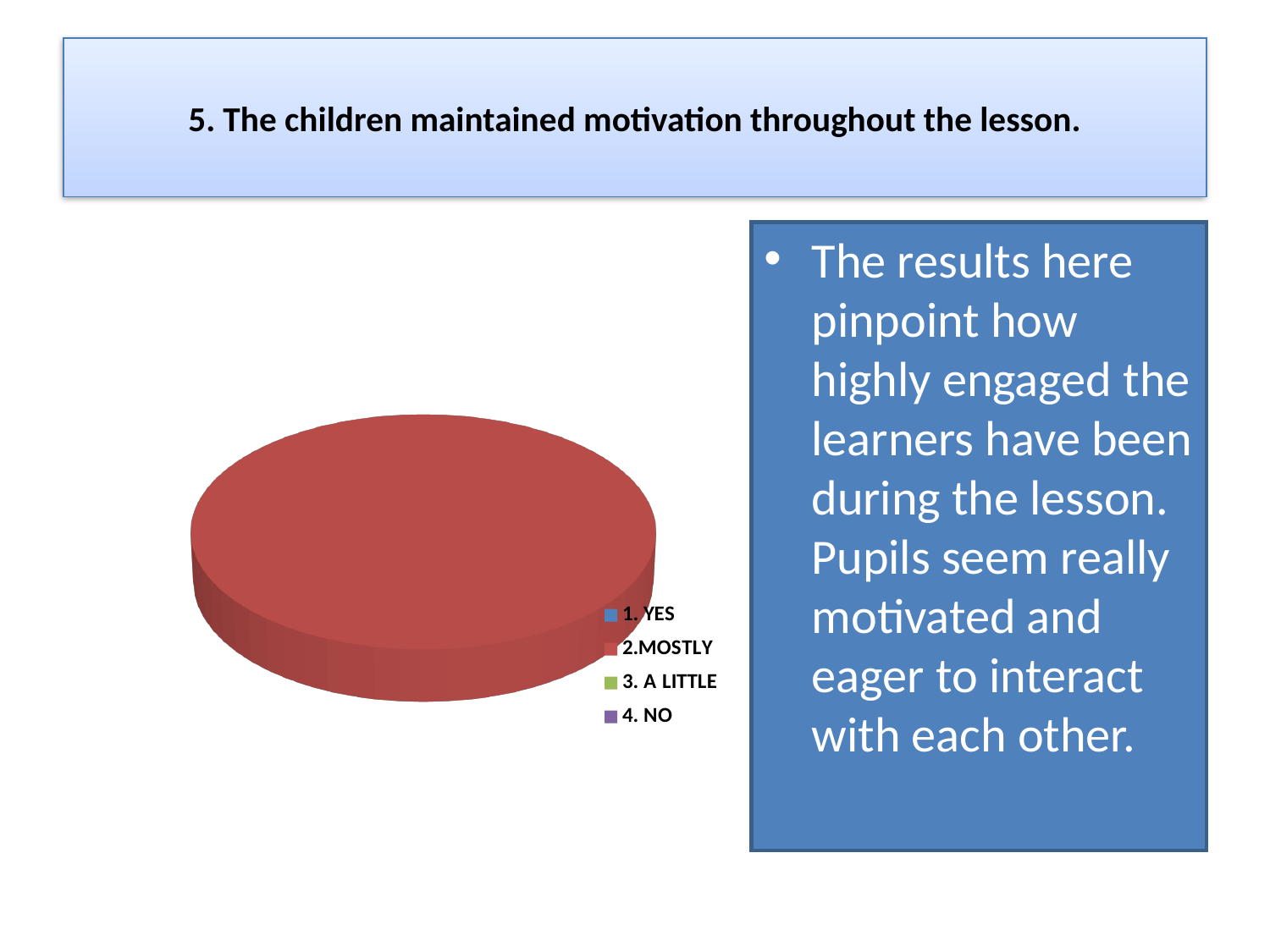
Is the share for 2.MOSTLY in the pie chart greater or less than 50%? greater What is the first category listed in the pie chart's legend? 1. YES How many categories does the legend of the pie chart list? 4 What kind of chart is shown on the slide? pie chart How many visibly distinct slices does the pie chart show? 1 Which category accounts for the largest share of the pie chart? 2.MOSTLY Which is larger in the pie chart, the share for 4. NO or the share for 2.MOSTLY? 2.MOSTLY Which is larger in the pie chart, the share for 2.MOSTLY or the share for 1. YES? 2.MOSTLY Which legend category does the red colour of the pie represent? 2.MOSTLY